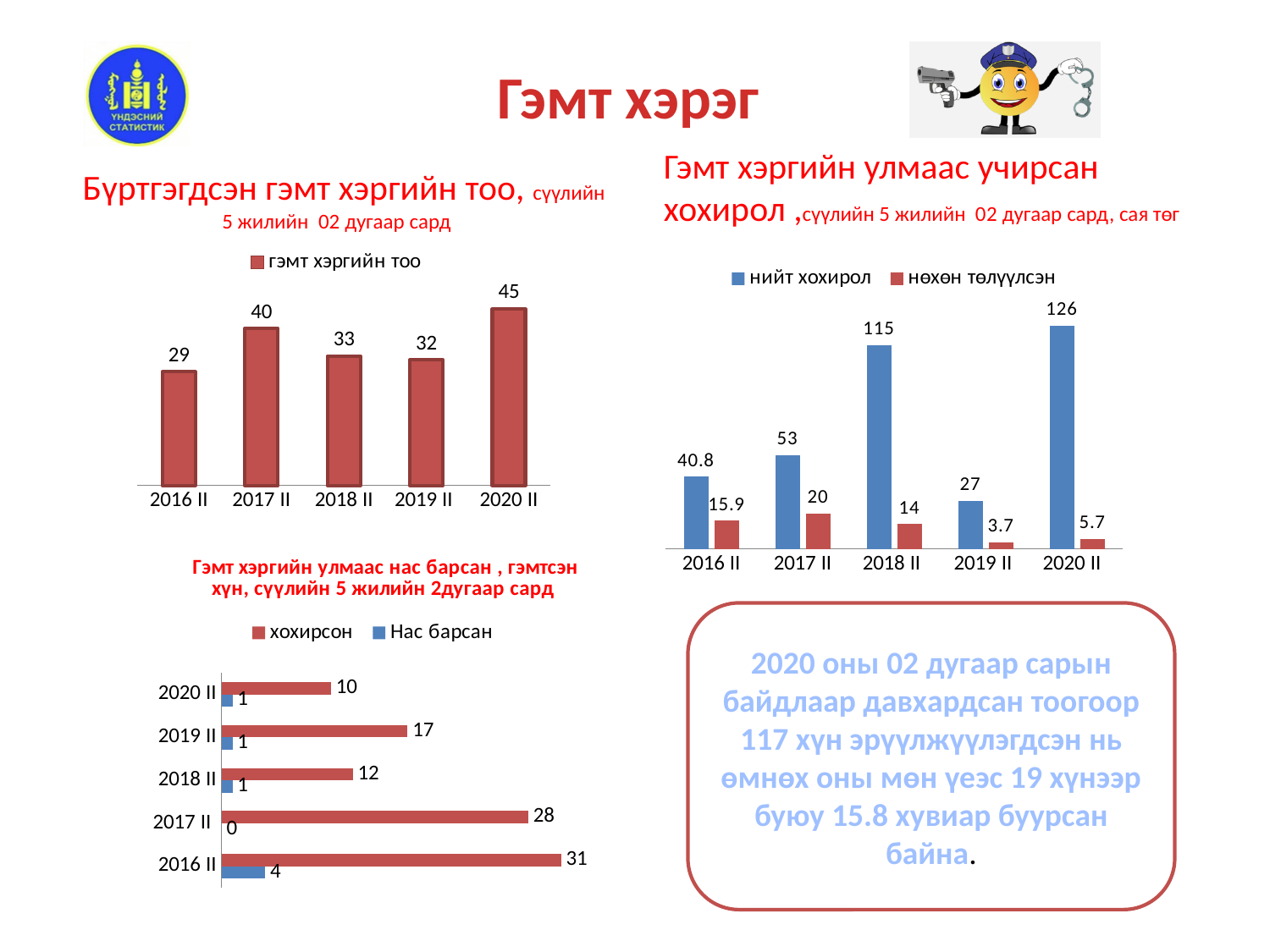
In the bottom-left chart 'Гэмт хэргийн улмаас нас барсан, гэмтсэн хүн', what is the 'хохирсон' value for 2017 II? 28 How many categories are shown on the x axis of the top-left chart 'Бүртгэгдсэн гэмт хэргийн тоо'? 5 In the top-left chart 'Бүртгэгдсэн гэмт хэргийн тоо', what is the difference between the values for 2017 II and 2016 II? 11 In the top-left chart 'Бүртгэгдсэн гэмт хэргийн тоо', which category has the lowest value? 2016 II In the top-right chart 'Гэмт хэргийн улмаас учирсан хохирол', what is the value of 'нөхөн төлүүлсэн' for 2016 II? 15.9 In the top-right chart 'Гэмт хэргийн улмаас учирсан хохирол', which category has the highest 'нийт хохирол' value? 2020 II In the top-right chart 'Гэмт хэргийн улмаас учирсан хохирол', which is larger: 'нөхөн төлүүлсэн' for 2017 II or for 2019 II? 2017 II In the top-right chart 'Гэмт хэргийн улмаас учирсан хохирол', what is the value of 'нийт хохирол' for 2018 II? 115 In the top-left chart 'Бүртгэгдсэн гэмт хэргийн тоо', what is the value for 2020 II? 45 What kind of chart is the bottom-left chart 'Гэмт хэргийн улмаас нас барсан, гэмтсэн хүн'? Bar chart In the bottom-left chart 'Гэмт хэргийн улмаас нас барсан, гэмтсэн хүн', what is the 'Нас барсан' value for 2016 II? 4 How many series does the legend of the top-right chart 'Гэмт хэргийн улмаас учирсан хохирол' list? 2